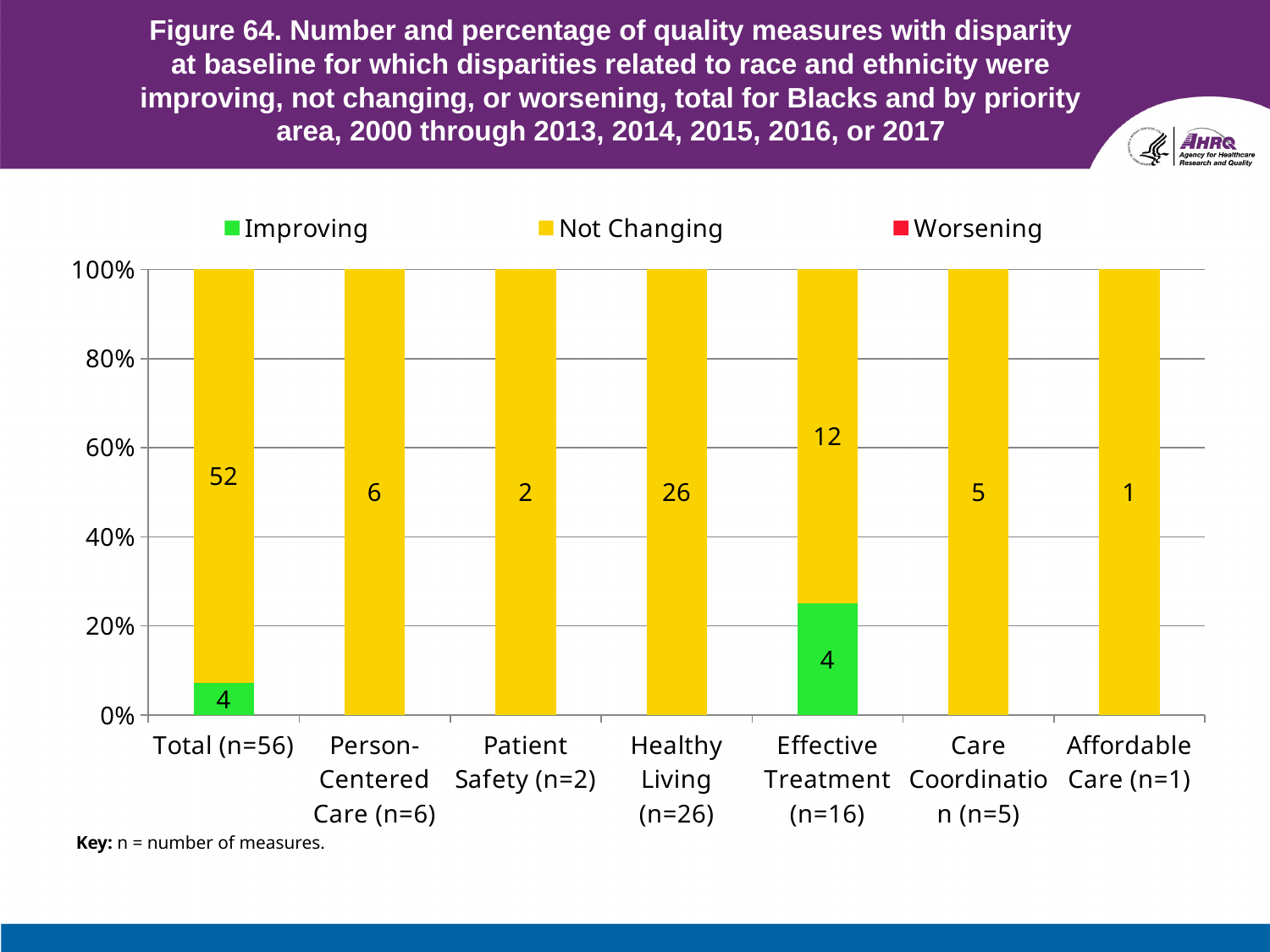
How many categories are shown on the x axis? 7 Which is larger, the Not Changing value for Person-Centered Care (n=6) or for Patient Safety (n=2)? Person-Centered Care (n=6) What is the Not Changing value for Healthy Living (n=26)? 26 What kind of chart is shown on the slide? Stacked bar chart Which category has the lowest Not Changing value? Affordable Care (n=1) Is the Improving share of the bar for Effective Treatment (n=16) greater or less than 20%? greater What is the difference between the Not Changing and Improving values for Effective Treatment (n=16)? 8 What is the Not Changing value for Total (n=56)? 52 What is the Not Changing value for Care Coordination (n=5)? 5 How many series does the legend list? 3 What is the Improving value for Effective Treatment (n=16)? 4 Which priority area has the highest Not Changing value (excluding Total)? Healthy Living (n=26)